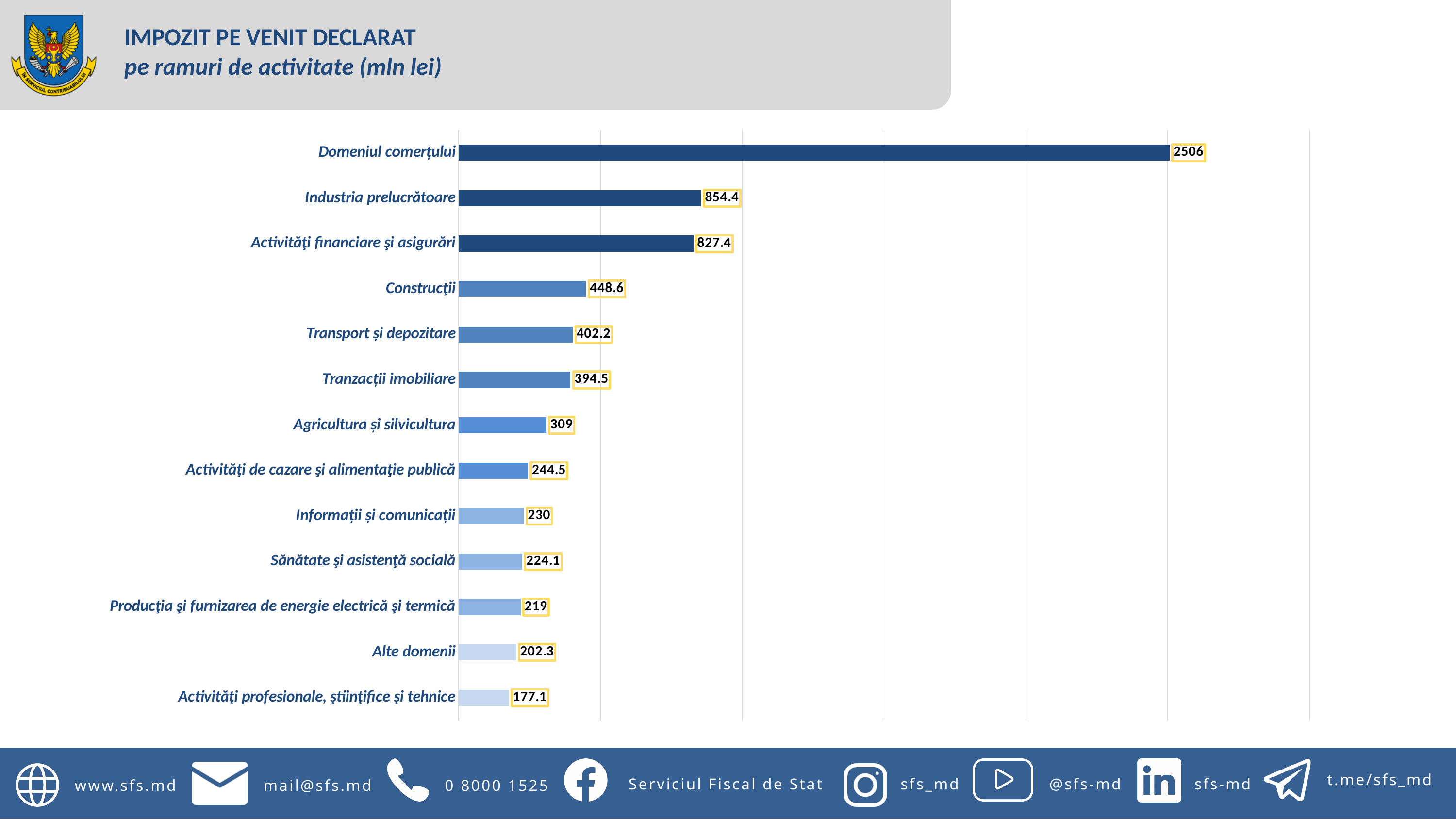
What is the difference between Domeniul comerțului and Industria prelucrătoare? 1651.6 Which category has the lowest value? Activități profesionale, științifice și tehnice How many categories are shown in the chart? 13 Which category has the highest value? Domeniul comerțului What kind of chart is shown on the slide? Bar chart What is the value for Domeniul comerțului? 2506 What is the difference between Construcții and Transport și depozitare? 46.4 What unit is stated in the slide title for the values? mln lei Which is larger, Industria prelucrătoare or Activități financiare și asigurări? Industria prelucrătoare What is the value for Construcții? 448.6 What is the value for Activități profesionale, științifice și tehnice? 177.1 What is the value for Agricultura și silvicultura? 309